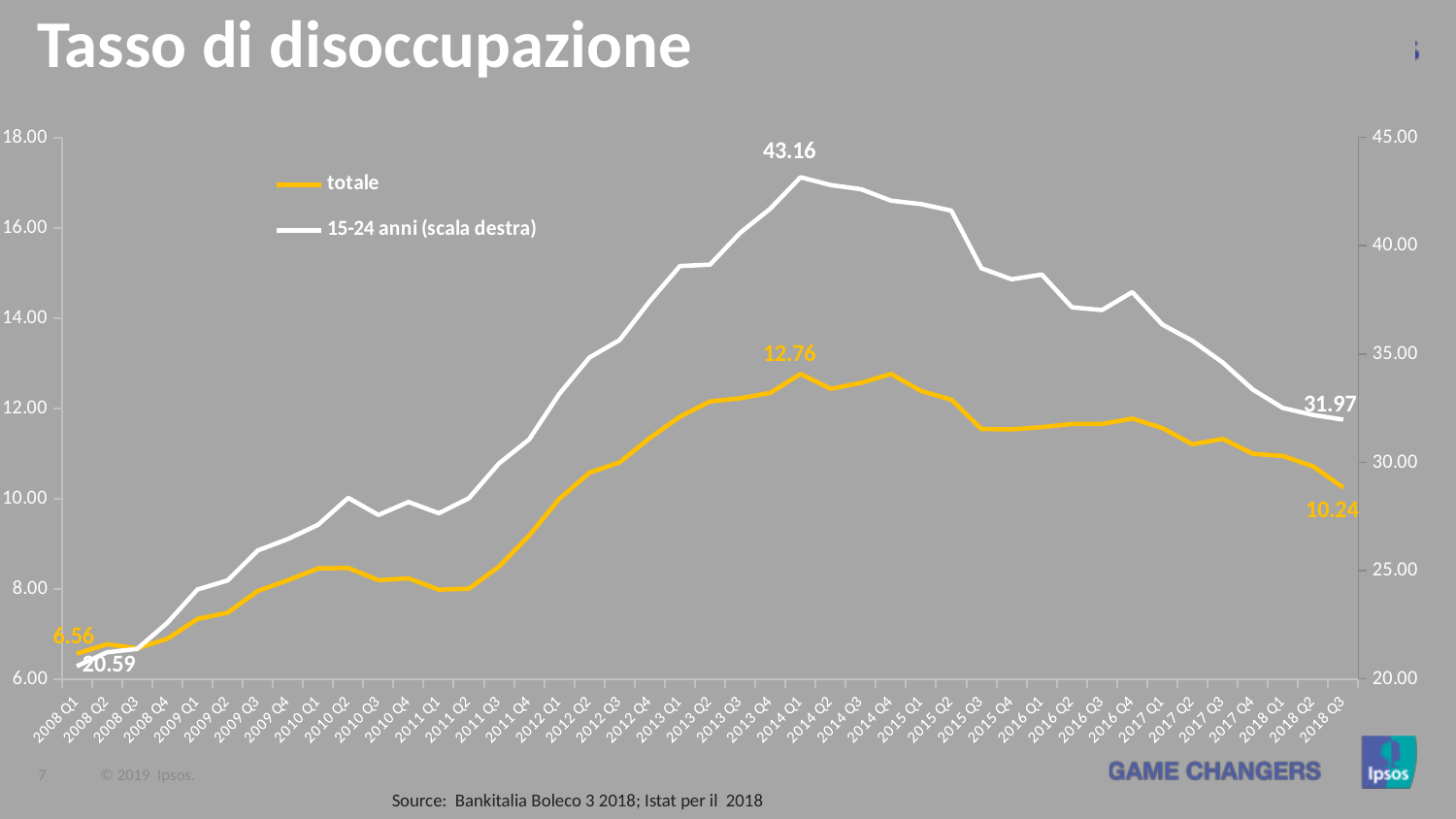
What is the value of the 'totale' series at 2008 Q1? 6.56 What is the difference between the labelled peak of the 'totale' series (12.76) and its 2008 Q1 value (6.56)? 6.20 How many series does the legend list? 2 What kind of chart is shown on the slide? line chart Does the 'totale' series rise or fall between 2014 Q1 and 2018 Q3? fall In which quarter does the '15-24 anni (scala destra)' series reach its highest value? 2014 Q1 What is the value of the 'totale' series at 2018 Q3? 10.24 Is the value of the 'totale' series at 2010 Q2 greater or less than 8.00? greater What is the peak value labelled on the '15-24 anni (scala destra)' series? 43.16 What is the value of the '15-24 anni (scala destra)' series at 2008 Q1? 20.59 By how much did the '15-24 anni (scala destra)' series fall from its peak of 43.16 to its 2018 Q3 value of 31.97? 11.19 What is the value of the '15-24 anni (scala destra)' series at 2018 Q3? 31.97